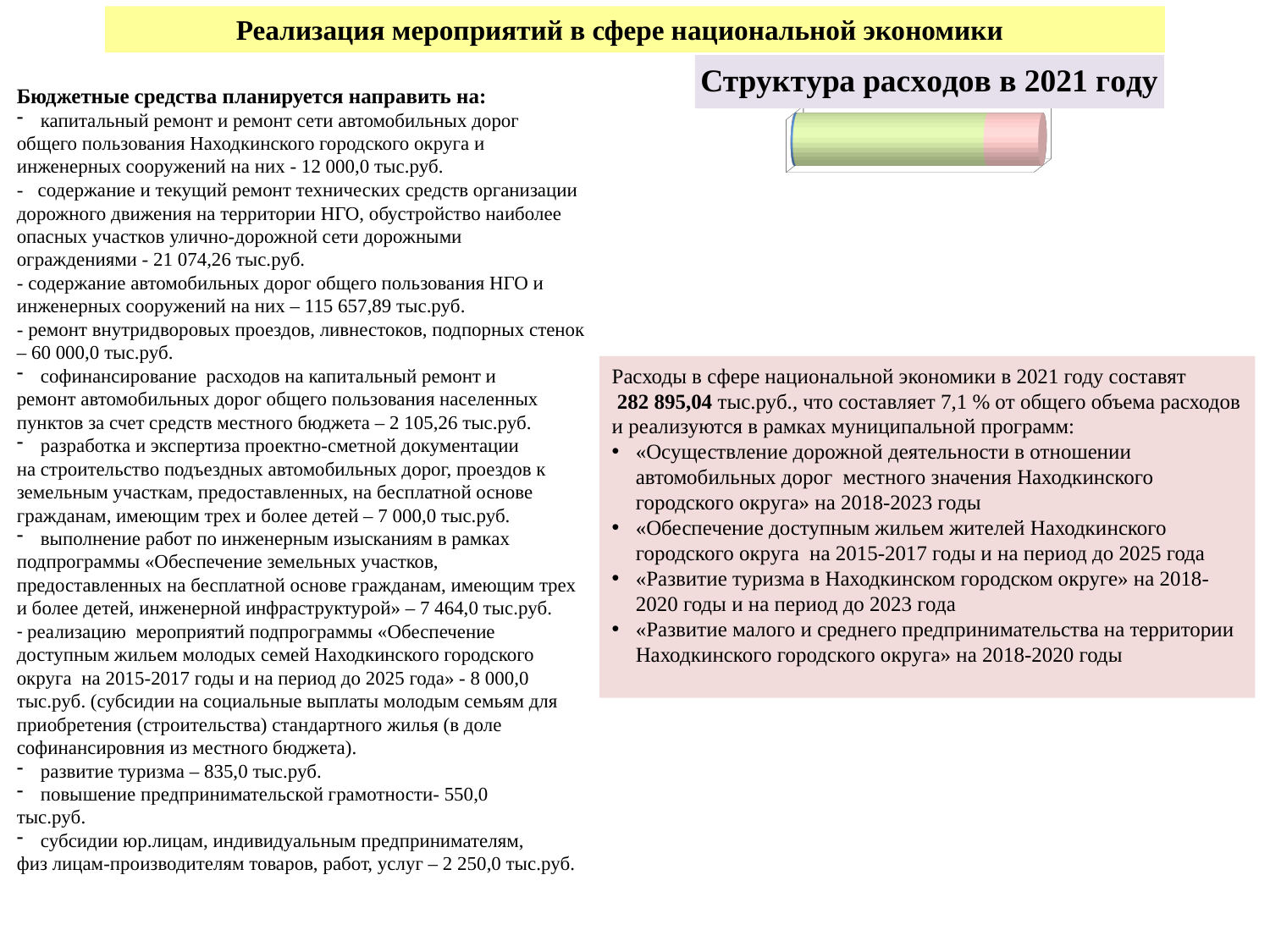
Is the bar in the chart "Структура расходов в 2021 году" oriented horizontally or vertically? horizontally In the chart "Структура расходов в 2021 году", which colour segment is the largest? green In the chart "Структура расходов в 2021 году", which segment is larger, the green one or the pink one? green What kind of chart is shown under the title "Структура расходов в 2021 году"? bar chart What is the title of the chart on the slide? Структура расходов в 2021 году